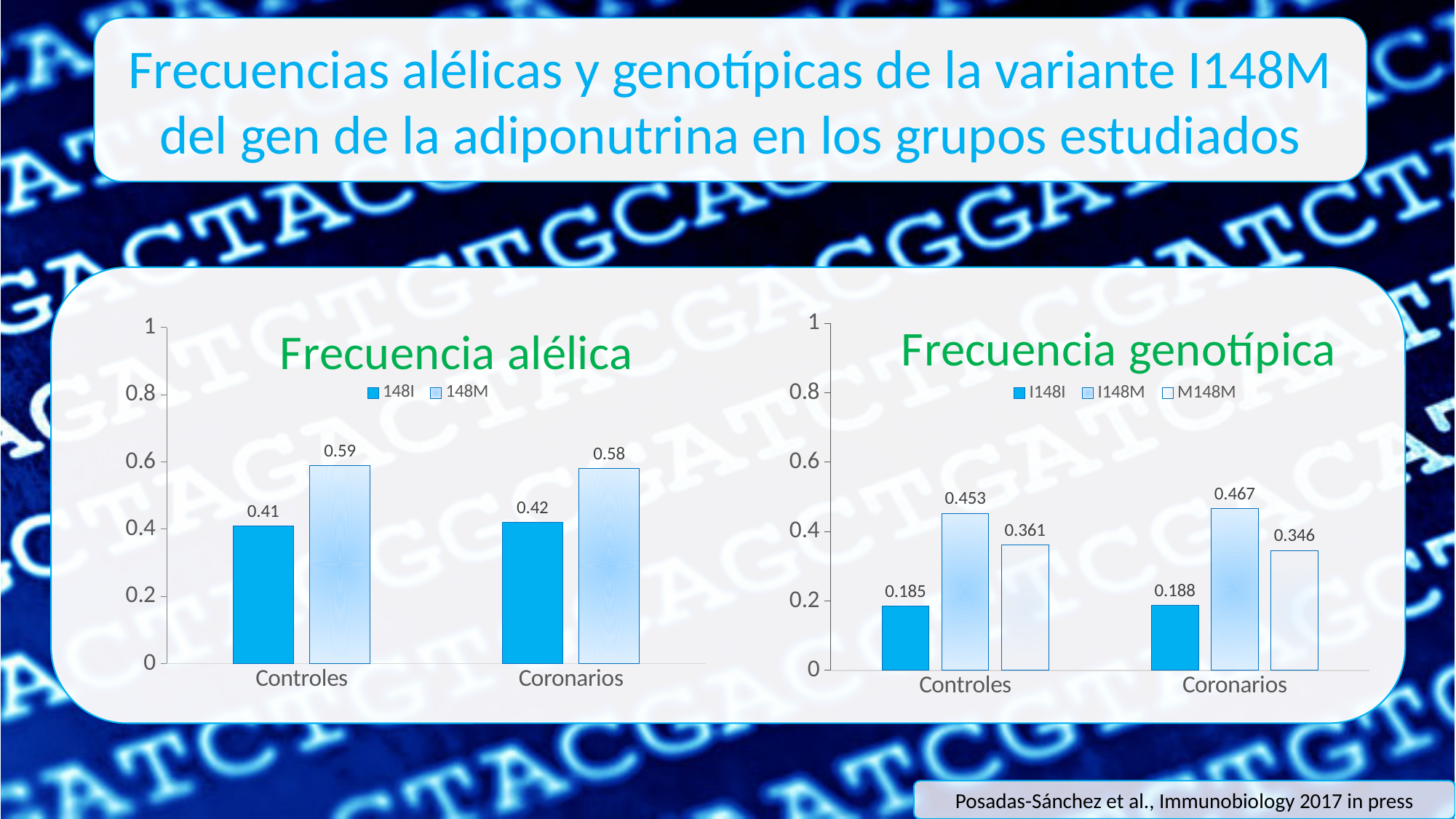
In the 'Frecuencia genotípica' chart, what is the value of I148M for Coronarios? 0.467 In the 'Frecuencia alélica' chart, what is the value of 148M for Controles? 0.59 How many categories are shown on the x axis of the 'Frecuencia alélica' chart? 2 In the 'Frecuencia alélica' chart, what is the difference between 148M and 148I for Controles? 0.18 In the 'Frecuencia alélica' chart, what is the value of 148I for Coronarios? 0.42 In the 'Frecuencia genotípica' chart, what is the value of M148M for Controles? 0.361 In the 'Frecuencia genotípica' chart, what is the difference between I148M and M148M for Coronarios? 0.121 In the 'Frecuencia genotípica' chart, is the value of I148I for Controles greater or less than 0.2? less In the 'Frecuencia genotípica' chart, which genotype has the lowest value for Coronarios? I148I In the 'Frecuencia alélica' chart, which is larger for Coronarios: 148I or 148M? 148M How many series does the legend of the 'Frecuencia genotípica' chart list? 3 What kind of chart is the 'Frecuencia genotípica' chart? bar chart